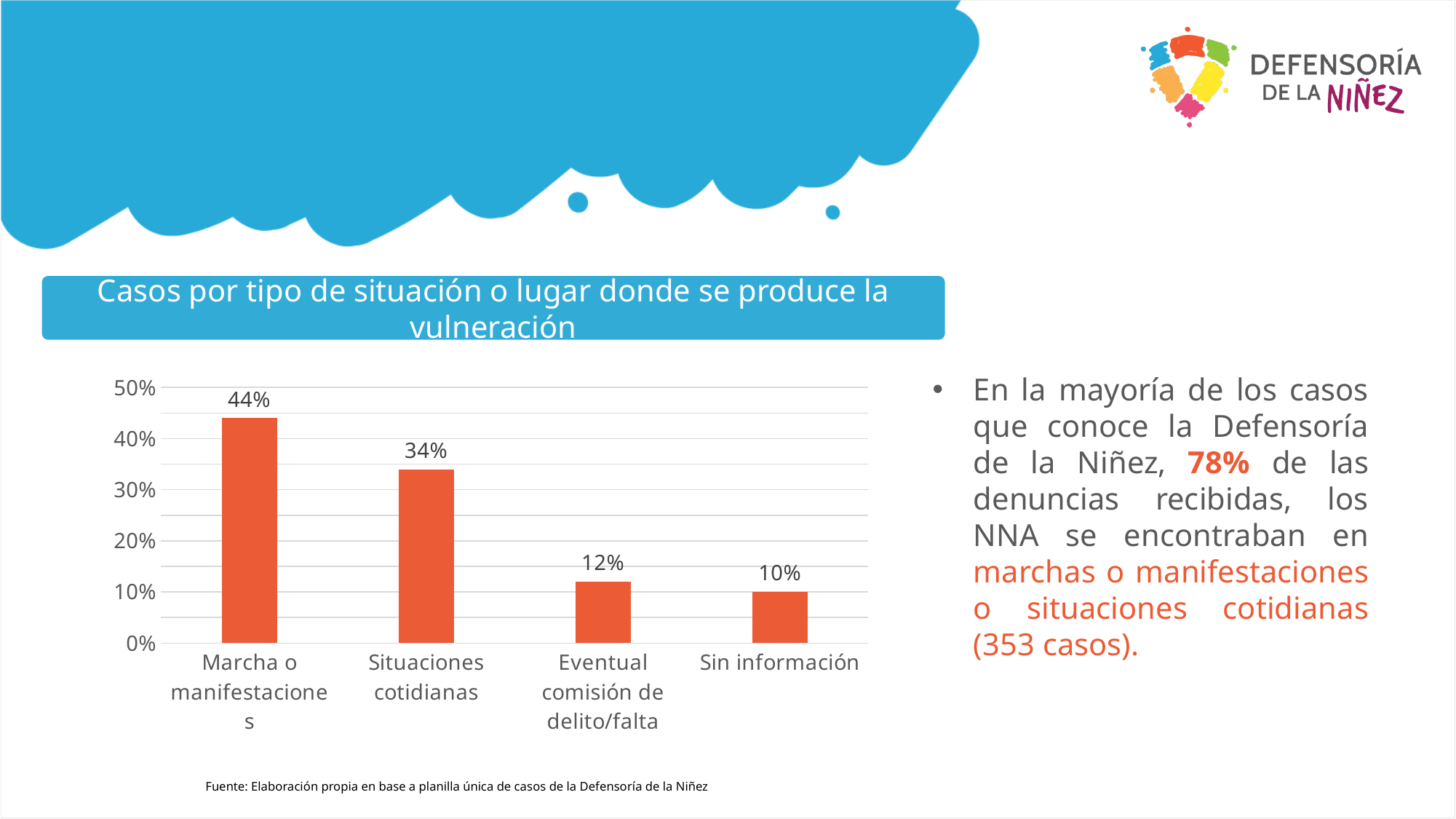
What is the difference between the values for Marcha o manifestaciones and Situaciones cotidianas? 10% How many categories are shown in the chart? 4 Which is larger, the value for Situaciones cotidianas or the value for Eventual comisión de delito/falta? Situaciones cotidianas What is the value for Marcha o manifestaciones? 44% Which category has the lowest value? Sin información What is the value for Situaciones cotidianas? 34% Is the value for Situaciones cotidianas greater or less than 30%? greater What kind of chart is shown on the slide? Bar chart What is the title of the chart? Casos por tipo de situación o lugar donde se produce la vulneración What is the value for Eventual comisión de delito/falta? 12% What is the value for Sin información? 10% Which category has the highest value? Marcha o manifestaciones